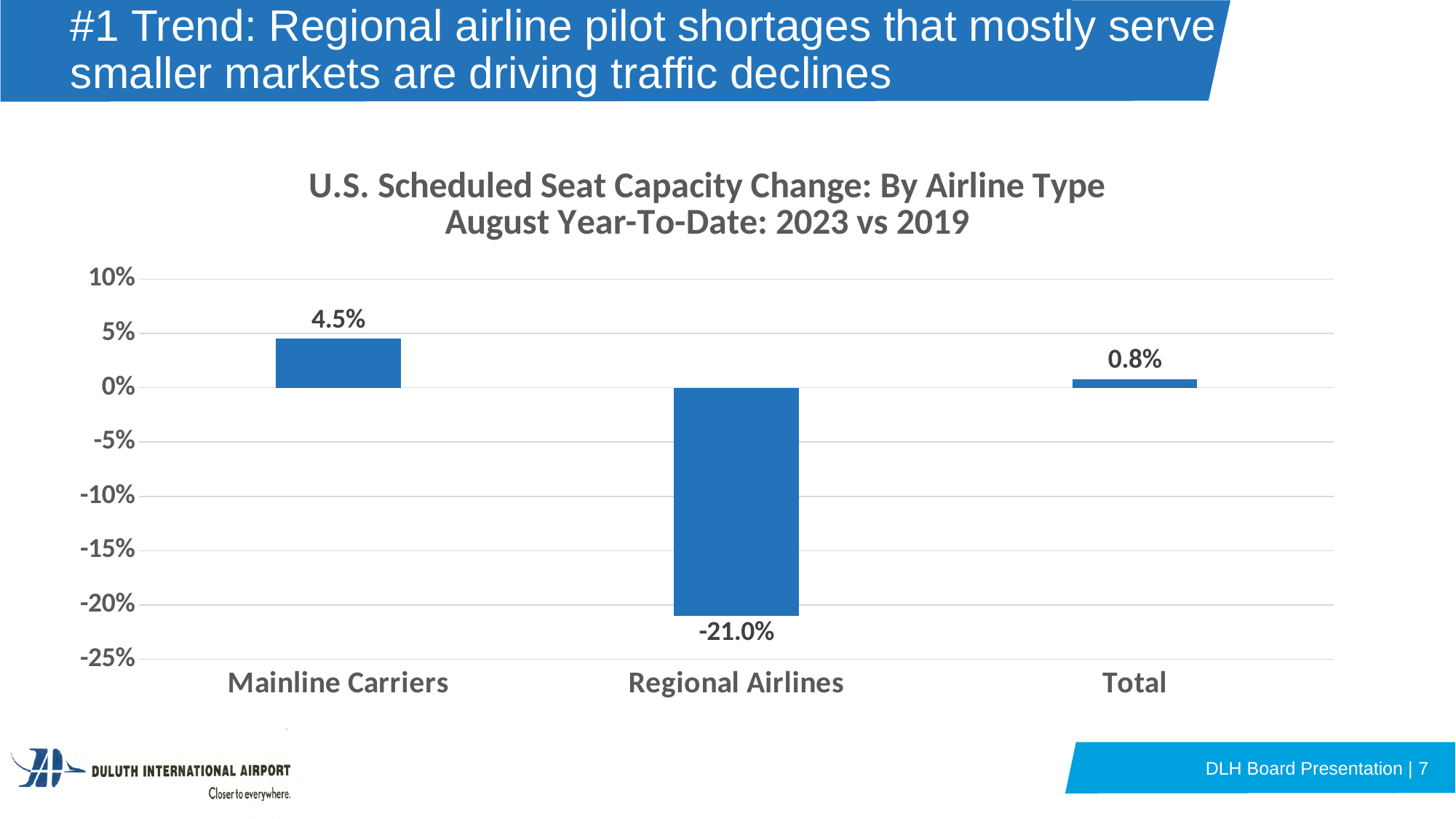
Which category has the lowest seat capacity change? Regional Airlines Which is larger, the value for Mainline Carriers or the value for Total? Mainline Carriers Is the value for Regional Airlines greater or less than -20%? less What is the difference between the Mainline Carriers value and the Total value? 3.7% What is the title of the chart? U.S. Scheduled Seat Capacity Change: By Airline Type August Year-To-Date: 2023 vs 2019 What kind of chart is shown on the slide? bar chart What is the seat capacity change for Regional Airlines? -21.0% Which category has the highest seat capacity change? Mainline Carriers What is the seat capacity change for Total? 0.8% What is the seat capacity change for Mainline Carriers? 4.5% How many categories are shown on the x axis? 3 What is the difference between the Mainline Carriers value and the Regional Airlines value? 25.5%